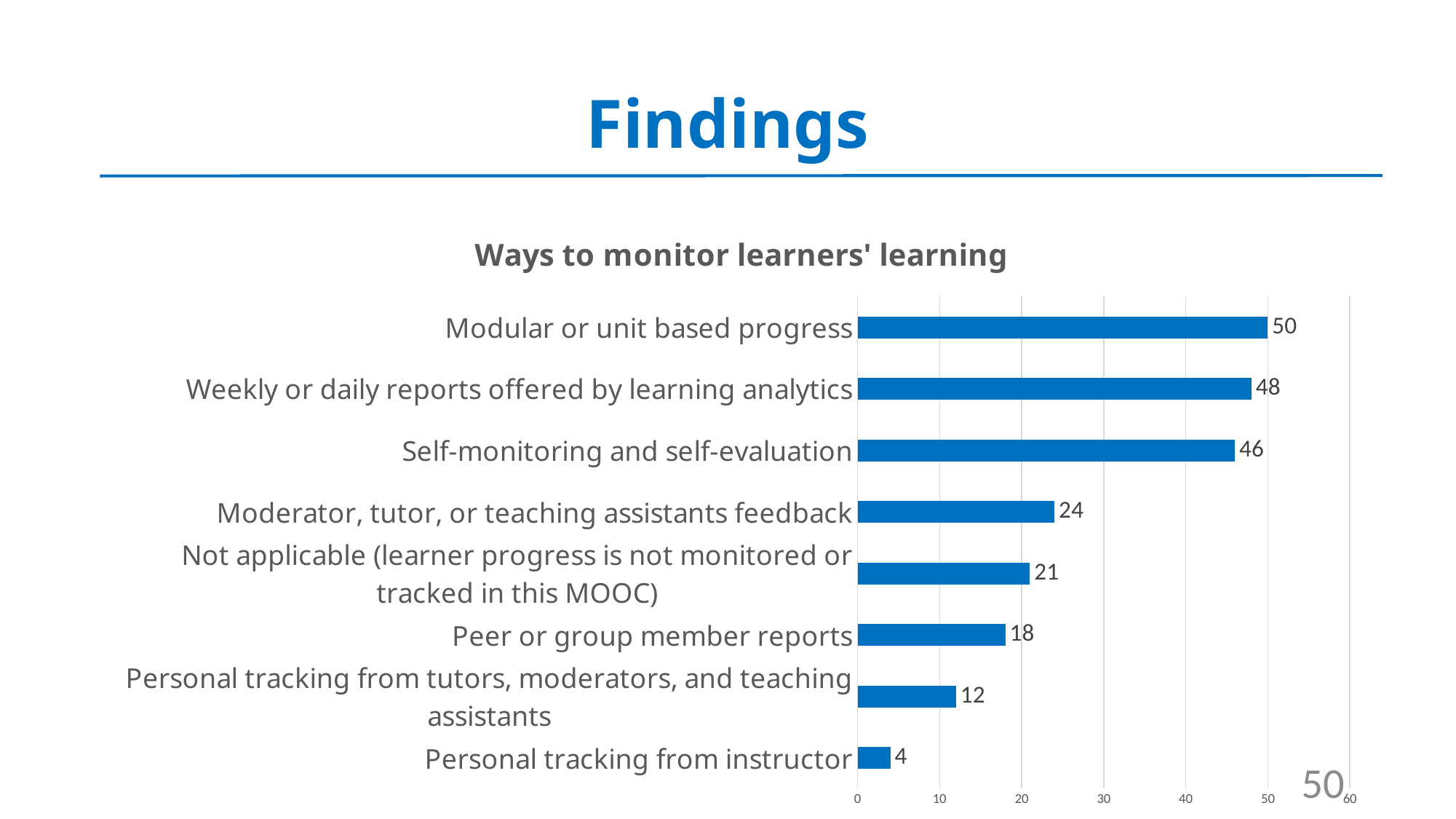
What is the value for Personal tracking from instructor? 4 What is the value for Modular or unit based progress? 50 Which category has the lowest value? Personal tracking from instructor What is the difference between Moderator, tutor, or teaching assistants feedback and Personal tracking from tutors, moderators, and teaching assistants? 12 Which is larger: Not applicable (learner progress is not monitored or tracked in this MOOC) or Peer or group member reports? Not applicable (learner progress is not monitored or tracked in this MOOC) What is the difference between Modular or unit based progress and Weekly or daily reports offered by learning analytics? 2 What is the value for Self-monitoring and self-evaluation? 46 What is the value for Peer or group member reports? 18 How many categories are shown in the chart? 8 What kind of chart is shown on the slide? Bar chart What is the title of the chart? Ways to monitor learners' learning Which category has the highest value? Modular or unit based progress